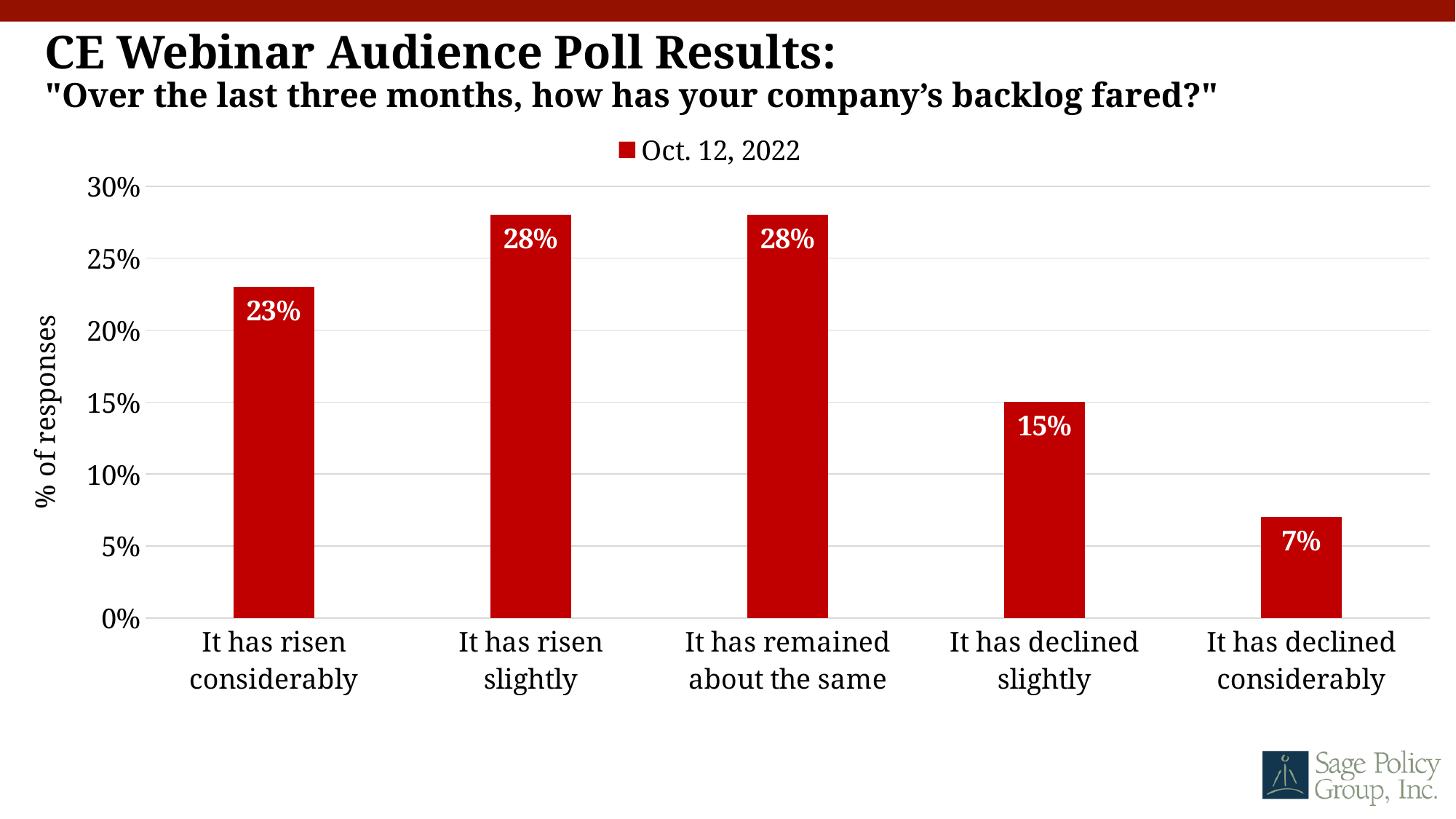
What date does the legend entry show? Oct. 12, 2022 What is the difference in percentage points between 'It has risen considerably' and 'It has declined considerably'? 16 percentage points What percentage of responses said the backlog has declined considerably? 7% What percentage of responses said the backlog has declined slightly? 15% What is the difference in percentage points between 'It has risen slightly' and 'It has declined slightly'? 13 percentage points What percentage of responses said the backlog has remained about the same? 28% Which response category has the lowest percentage of responses? It has declined considerably What percentage of responses said the backlog has risen considerably? 23% How many series does the legend list? 1 How many response categories are shown on the x axis? 5 What kind of chart is shown on the slide? Bar chart Which is larger: the share for 'It has risen considerably' or 'It has declined slightly'? It has risen considerably